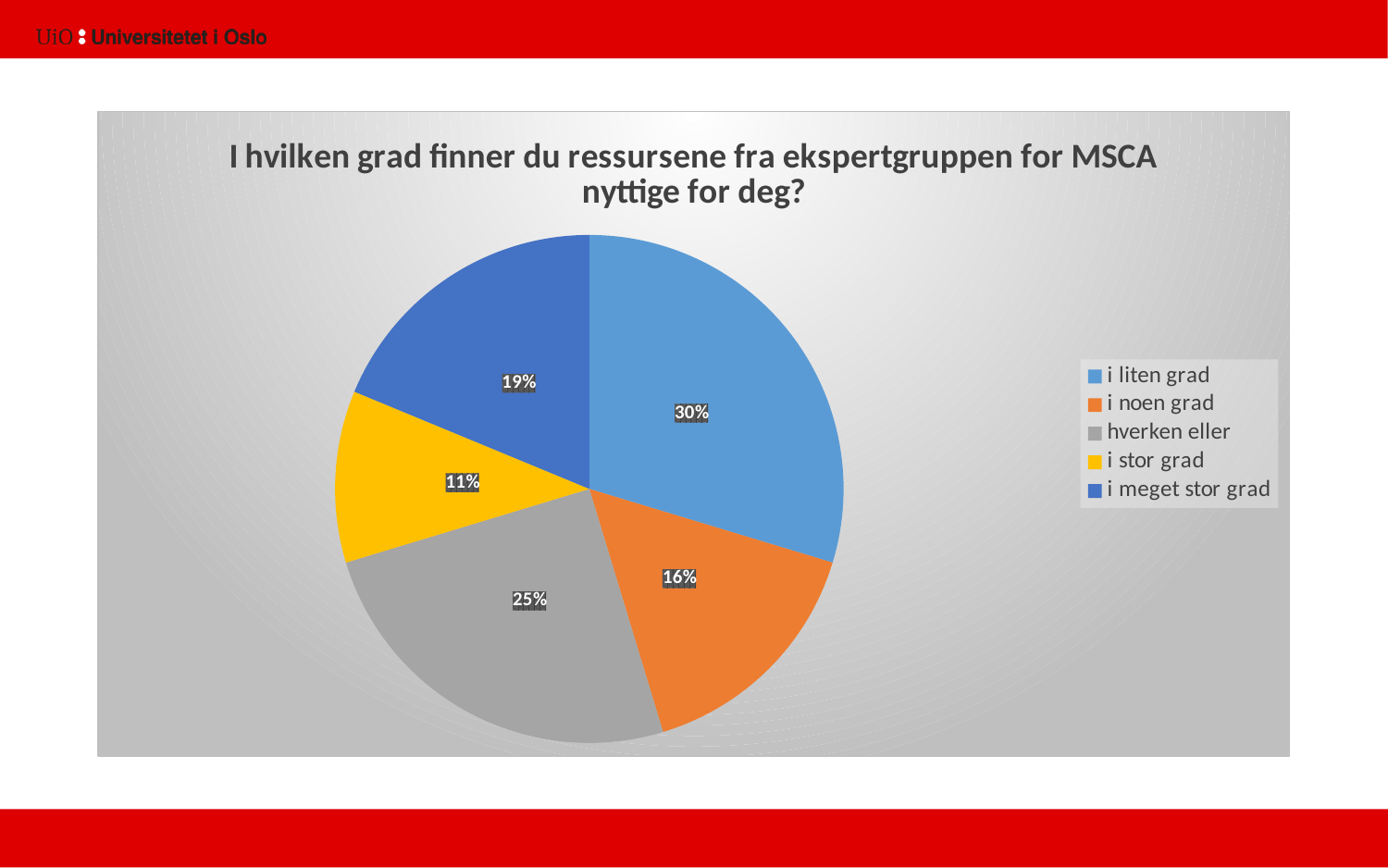
What type of chart is shown on the slide? pie chart What percentage of the pie is 'hverken eller'? 25% What percentage of the pie is 'i liten grad'? 30% What is the difference in percentage points between 'i liten grad' and 'i noen grad'? 14 Which is larger, the share for 'hverken eller' or the share for 'i meget stor grad'? hverken eller Which category has the largest share of the pie? i liten grad What percentage of the pie is 'i meget stor grad'? 19% What percentage of the pie is 'i noen grad'? 16% What percentage of the pie is 'i stor grad'? 11% How many categories does the legend list? 5 What is the title of the chart? I hvilken grad finner du ressursene fra ekspertgruppen for MSCA nyttige for deg? Which category has the smallest share of the pie? i stor grad